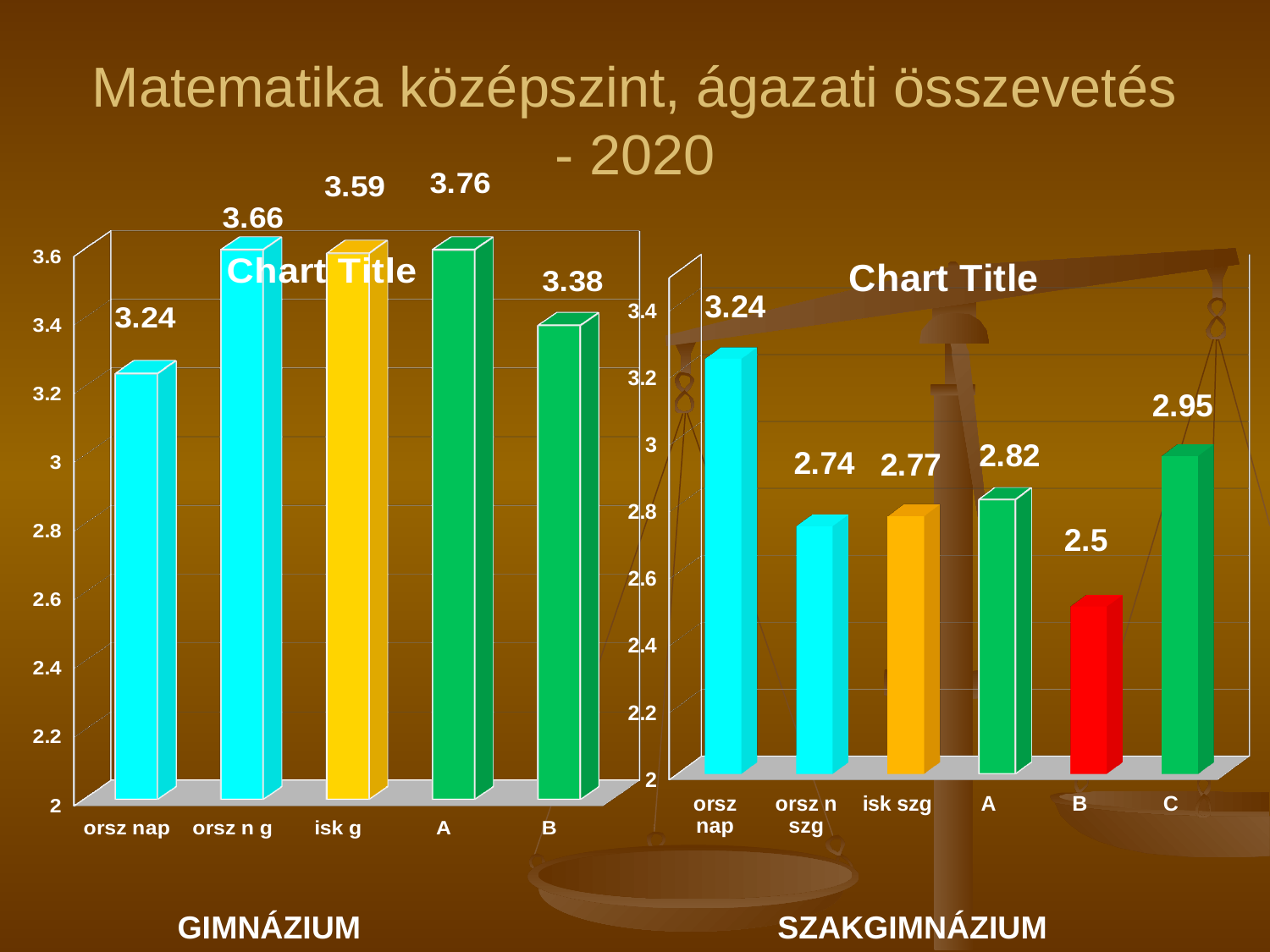
In the right chart (SZAKGIMNÁZIUM), what is the value for isk szg? 2.77 In the right chart (SZAKGIMNÁZIUM), which category has the lowest value? B How many categories are shown in the right chart (SZAKGIMNÁZIUM)? 6 What kind of chart is the left chart (GIMNÁZIUM)? Bar chart In the right chart (SZAKGIMNÁZIUM), what is the value for B? 2.5 In the left chart (GIMNÁZIUM), which is larger, the value for isk g or the value for B? isk g In the left chart (GIMNÁZIUM), what is the value for A? 3.76 In the left chart (GIMNÁZIUM), what is the difference between the values for A and B? 0.38 In the left chart (GIMNÁZIUM), what is the value for orsz n g? 3.66 In the right chart (SZAKGIMNÁZIUM), which category has the highest value? orsz nap In the left chart (GIMNÁZIUM), which category has the highest value? A In the right chart (SZAKGIMNÁZIUM), what is the difference between the values for C and B? 0.45